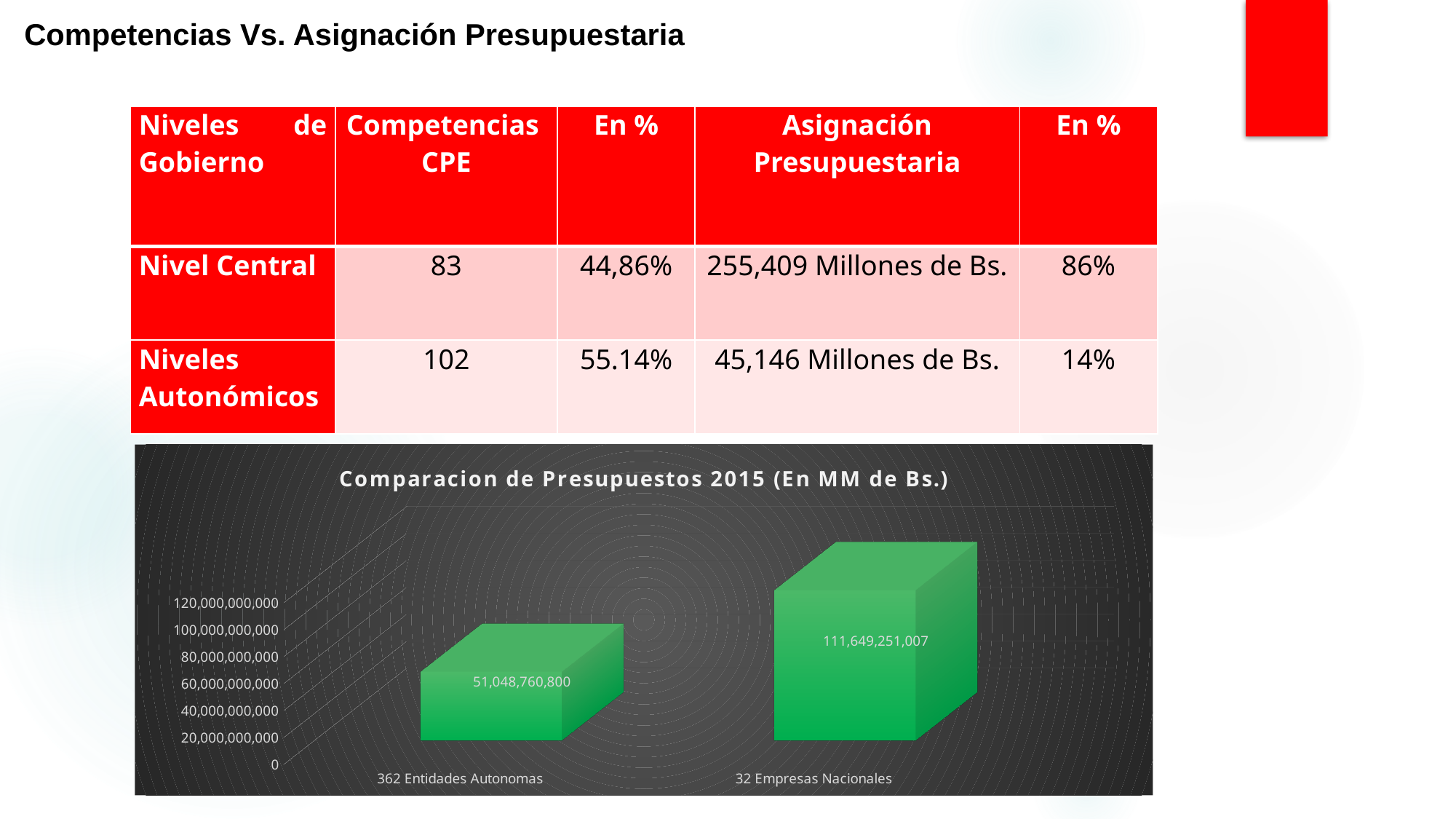
What is the title of the chart? Comparacion de Presupuestos 2015 (En MM de Bs.) What is the value for 32 Empresas Nacionales in the chart? 111,649,251,007 What is the value for 362 Entidades Autonomas in the chart? 51,048,760,800 Is the value for 32 Empresas Nacionales greater or less than 100,000,000,000? greater What is the difference between the values for 32 Empresas Nacionales and 362 Entidades Autonomas? 60,600,490,207 Is the value for 362 Entidades Autonomas greater or less than 60,000,000,000? less What kind of chart is shown on the slide? bar chart What is the highest value shown on the chart's vertical axis? 120,000,000,000 Which category has the highest value in the chart? 32 Empresas Nacionales Which is larger, the value for 362 Entidades Autonomas or the value for 32 Empresas Nacionales? 32 Empresas Nacionales How many categories are shown in the chart? 2 Which category has the lowest value in the chart? 362 Entidades Autonomas